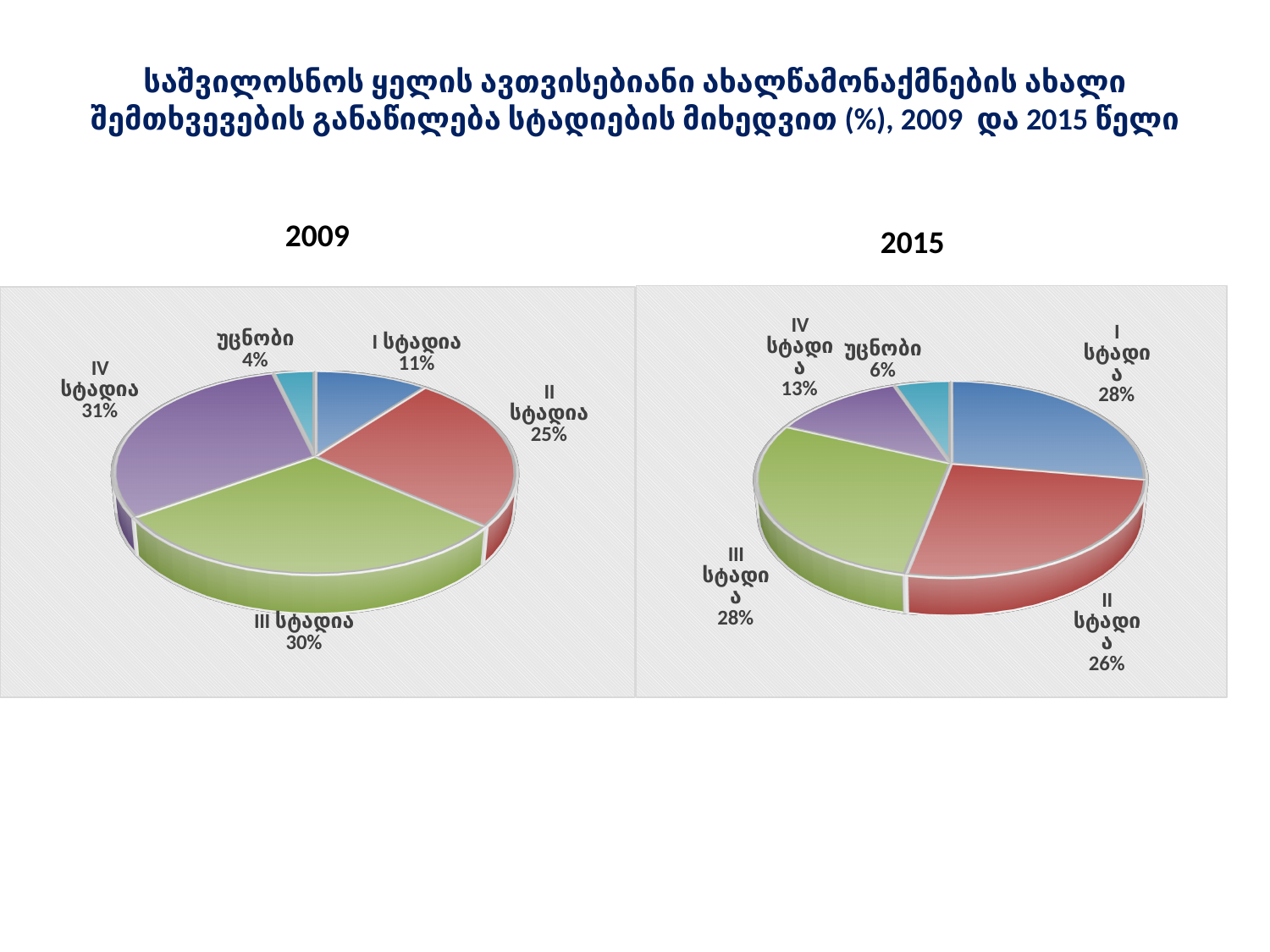
In the 2015 pie chart, what is the share for IV სტადია? 13% In the 2015 pie chart, what is the difference between the shares of II სტადია and IV სტადია? 13% What kind of chart is used for the 2009 data? Pie chart In the 2009 pie chart, what is the share for უცნობი? 4% In the 2009 pie chart, what is the share for IV სტადია? 31% In the 2009 pie chart, which category has the largest share? IV სტადია In the 2015 pie chart, which category has the smallest share? უცნობი In the 2009 pie chart, which category has the smallest share? უცნობი What is the difference between the share of I სტადია in 2015 and in 2009? 17% In the 2009 pie chart, which is larger: the share of II სტადია or the share of I სტადია? II სტადია How many slices does the 2015 pie chart have? 5 In the 2015 pie chart, what is the share for I სტადია? 28%